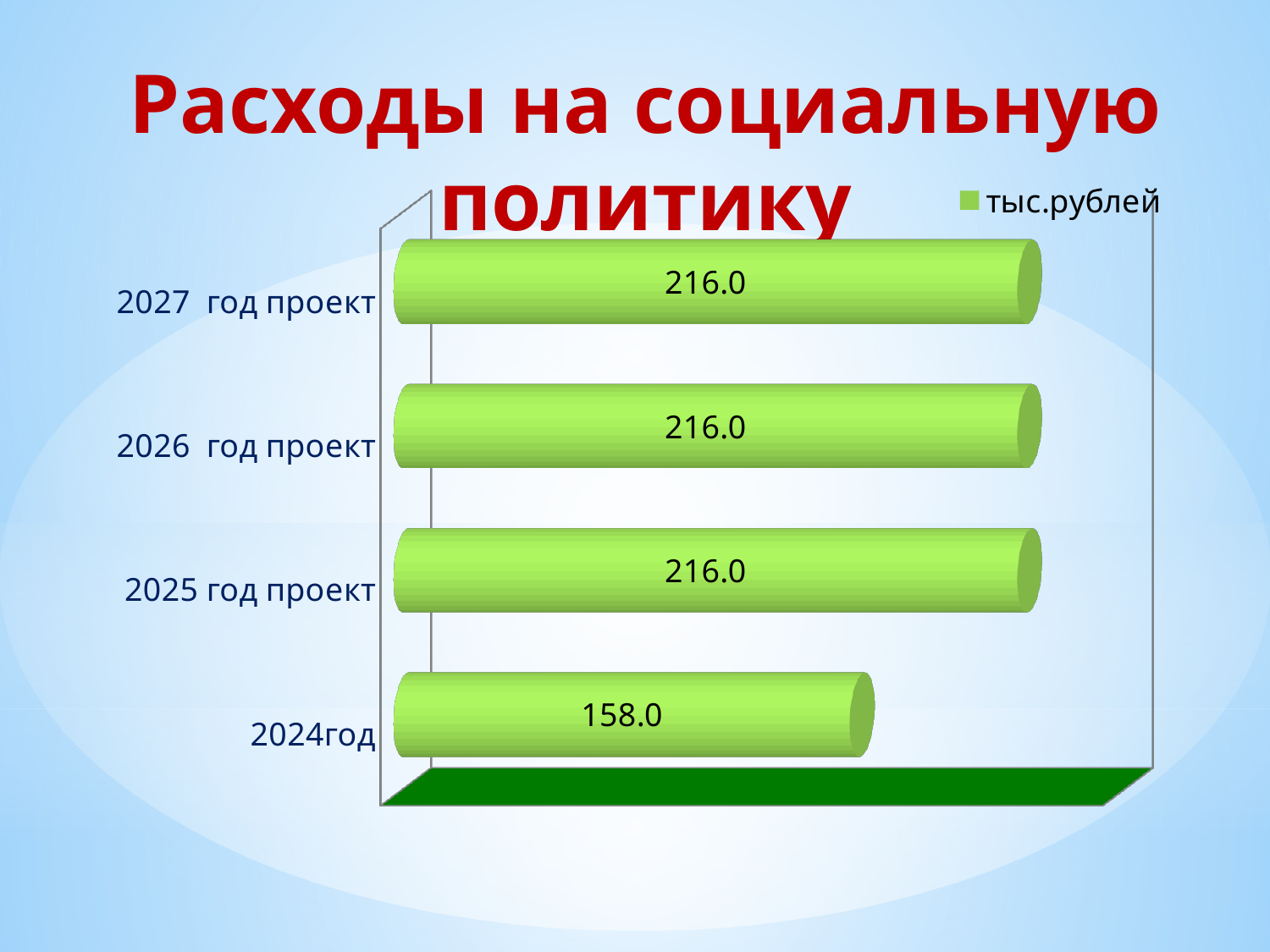
Which category has the lowest value? 2024год What is the difference between the values for 2025 год проект and 2024год? 58.0 What is the value for 2024год? 158.0 How many categories are shown in the chart? 4 What series name does the legend show? тыс.рублей What is the value for 2025 год проект? 216.0 Do the values rise or fall from 2024год to 2025 год проект? rise Which is larger, the value for 2026 год проект or the value for 2024год? 2026 год проект What is the title of the chart? Расходы на социальную политику How many series does the legend list? 1 What kind of chart is shown on the slide? bar chart What is the value for 2027 год проект? 216.0